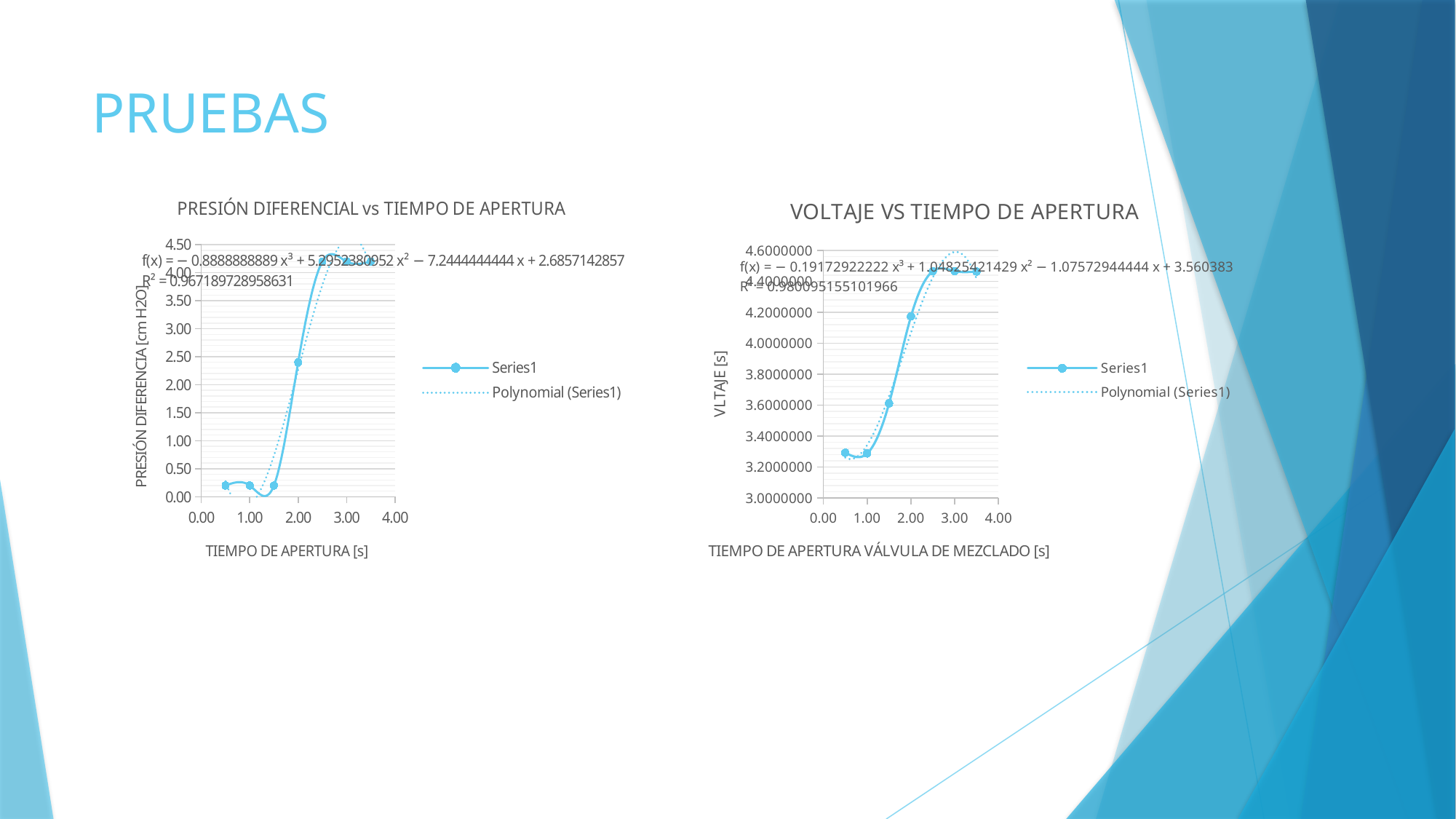
What is the R² value shown on the PRESIÓN DIFERENCIAL vs TIEMPO DE APERTURA chart? 0.967189728958631 What kind of chart is the PRESIÓN DIFERENCIAL vs TIEMPO DE APERTURA chart on the left? Line chart In the VOLTAJE VS TIEMPO DE APERTURA chart, is the value at 1.00 s greater or less than 3.4000000? less In the PRESIÓN DIFERENCIAL vs TIEMPO DE APERTURA chart, is the value at 2.00 s greater or less than 2.00? greater How many entries does the legend of the VOLTAJE VS TIEMPO DE APERTURA chart list? 2 In the VOLTAJE VS TIEMPO DE APERTURA chart, is the value at 2.00 s greater or less than 4.0000000? greater In the VOLTAJE VS TIEMPO DE APERTURA chart, do the values generally rise or fall as the opening time increases? Rise In the PRESIÓN DIFERENCIAL vs TIEMPO DE APERTURA chart, do the values generally rise or fall as the opening time increases? Rise In the PRESIÓN DIFERENCIAL vs TIEMPO DE APERTURA chart, which is larger: the value at 1.00 s or the value at 2.00 s? 2.00 s What is the x-axis title of the VOLTAJE VS TIEMPO DE APERTURA chart? TIEMPO DE APERTURA VÁLVULA DE MEZCLADO [s] In the VOLTAJE VS TIEMPO DE APERTURA chart, which is larger: the value at 1.50 s or the value at 2.00 s? 2.00 s